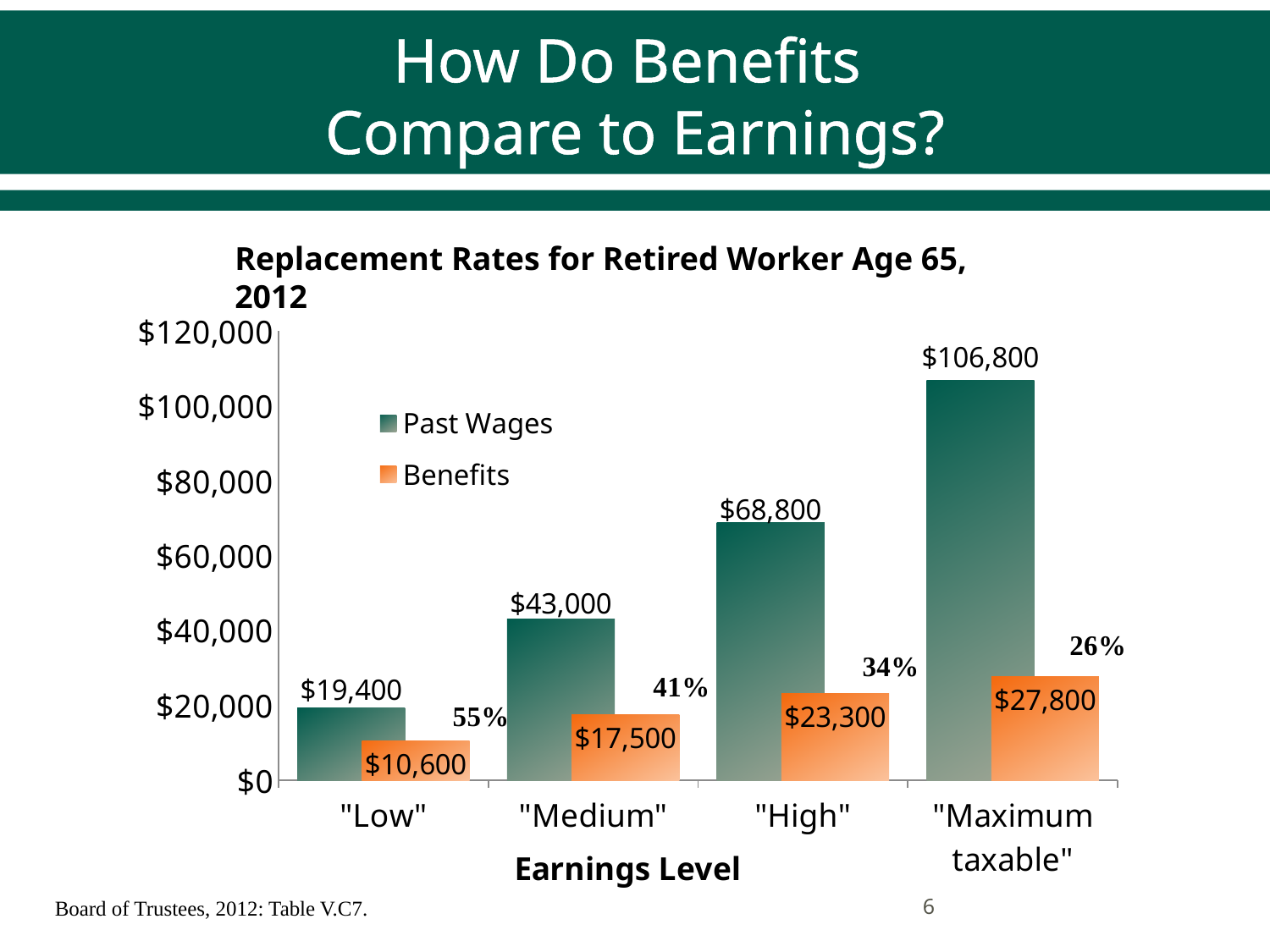
How many earnings levels are shown on the x axis? 4 How many series does the legend list? 2 What is the Past Wages value for the "Maximum taxable" earnings level? $106,800 What kind of chart is shown on the slide? bar chart Which earnings level has the highest Benefits value? "Maximum taxable" What is the Past Wages value for the "Low" earnings level? $19,400 What replacement rate percentage is shown above the Benefits bar for the "Low" earnings level? 55% What is the Benefits value for the "High" earnings level? $23,300 What is the difference between Past Wages and Benefits for the "Medium" earnings level? $25,500 Which earnings level has the lowest Past Wages value? "Low" Which is larger: Benefits for "Medium" or Benefits for "High"? Benefits for "High" Is the Past Wages value for "High" greater or less than $60,000? greater